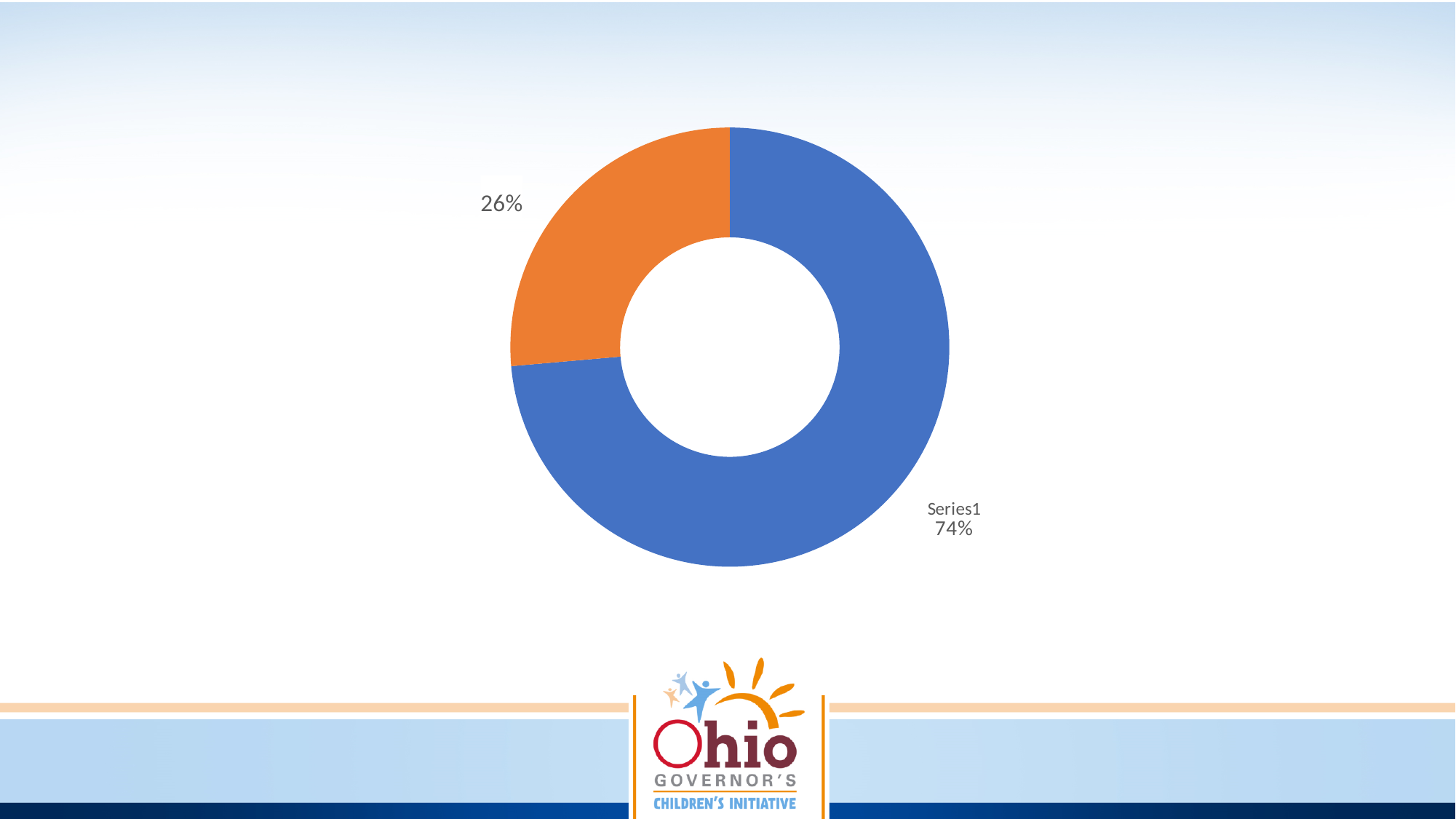
What share of the doughnut does the orange slice represent? 26% What do the two slice percentages in the doughnut chart add up to? 100% Is the blue slice's value greater or less than 50%? greater What text label appears next to the blue slice of the doughnut chart? Series1 How many slices does the doughnut chart have? 2 What kind of chart is shown on the slide? doughnut chart What percentage is shown for the blue slice of the doughnut chart? 74% Which slice of the doughnut chart is the largest, the blue one or the orange one? blue By how many percentage points does the blue slice exceed the orange slice? 48 percentage points What percentage is shown for the orange slice of the doughnut chart? 26% Which slice of the doughnut chart is the smallest, the blue one or the orange one? orange